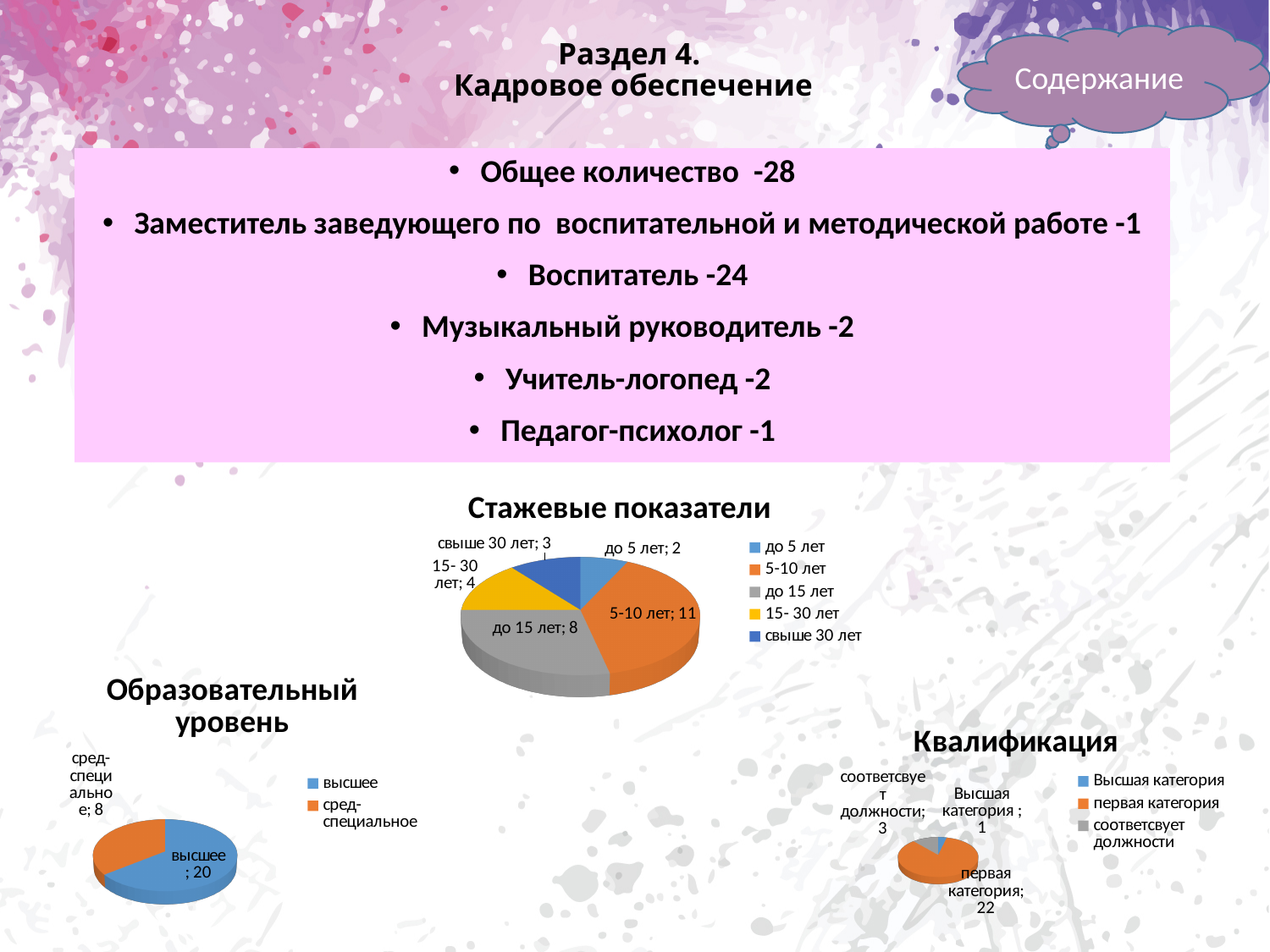
In the 'Образовательный уровень' chart, what is the value for 'высшее'? 20 In the 'Квалификация' chart, what is the value for 'первая категория'? 22 In the 'Образовательный уровень' chart, what is the difference between 'высшее' and 'сред-специальное'? 12 In the 'Квалификация' chart, which category has the smallest value? Высшая категория In the 'Стажевые показатели' chart, what is the value for '5-10 лет'? 11 What type of chart is 'Стажевые показатели'? Pie chart In the 'Стажевые показатели' chart, which category has the smallest value? до 5 лет How many entries does the legend of the 'Квалификация' chart list? 3 How many categories does the 'Стажевые показатели' pie chart show? 5 In the 'Стажевые показатели' chart, which category has the largest value? 5-10 лет In the 'Образовательный уровень' chart, which is larger: 'высшее' or 'сред-специальное'? высшее In the 'Стажевые показатели' chart, what is the difference between the values for 'до 15 лет' and '15- 30 лет'? 4